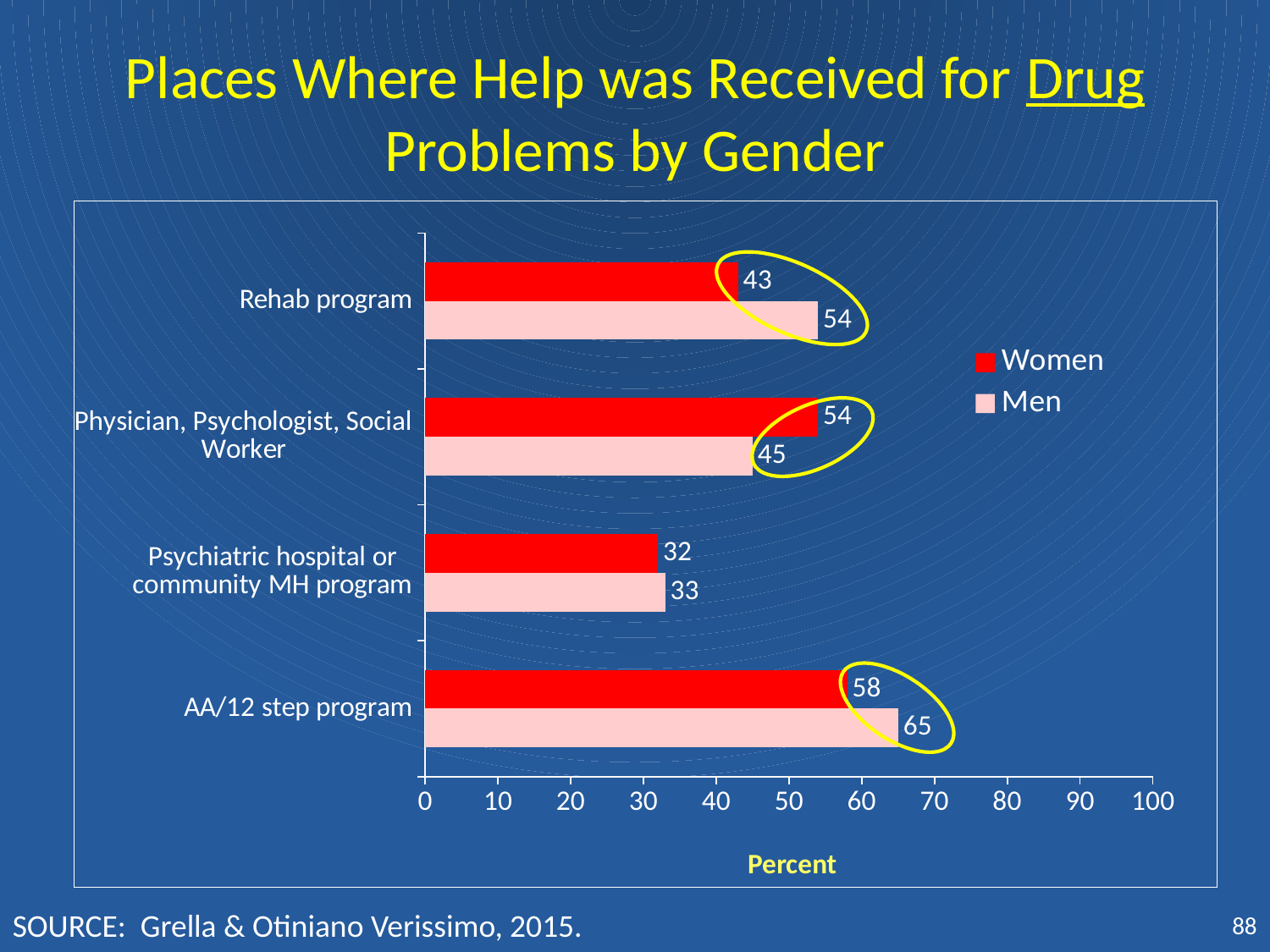
What is the label of the horizontal axis? Percent What is the value for Men for AA/12 step program? 65 What is the value for Women for Rehab program? 43 Which category has the highest value for Men? AA/12 step program How many categories are shown on the chart? 4 For Physician, Psychologist, Social Worker, which is larger: the value for Women or the value for Men? Women What is the value for Men for Physician, Psychologist, Social Worker? 45 Which category has the lowest value for Women? Psychiatric hospital or community MH program What kind of chart is shown on the slide? Bar chart What is the difference between the Men and Women values for AA/12 step program? 7 How many series does the legend list? 2 What is the difference between the Men and Women values for Rehab program? 11